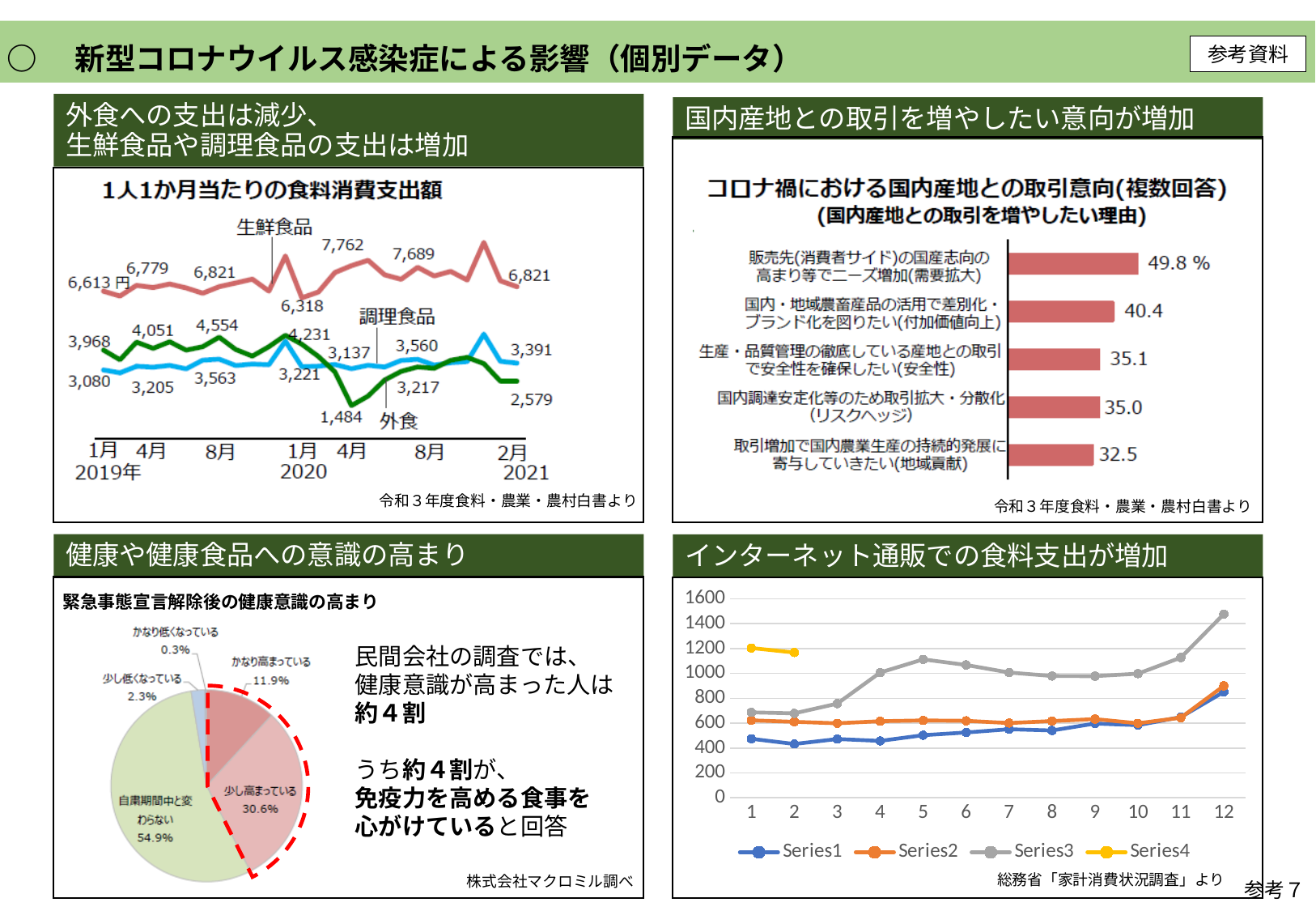
In the top-left chart titled 1人1か月当たりの食料消費支出額, what is the lowest labelled value for 外食? 1,484 In the top-left chart titled 1人1か月当たりの食料消費支出額, what is the highest labelled value for 生鮮食品? 7,762 In the bottom-left pie chart 緊急事態宣言解除後の健康意識の高まり, what share is 自粛期間中と変わらない? 54.9% In the top-left chart titled 1人1か月当たりの食料消費支出額, how many series are plotted? 3 In the top-left chart titled 1人1か月当たりの食料消費支出額, what is the value for 生鮮食品 at 2月 2021? 6,821 In the top-right chart titled コロナ禍における国内産地との取引意向, which reason has the lowest value? 取引増加で国内農業生産の持続的発展に寄与していきたい(地域貢献) In the bottom-left pie chart 緊急事態宣言解除後の健康意識の高まり, what is the combined share of かなり高まっている and 少し高まっている? 42.5% In the top-right chart titled コロナ禍における国内産地との取引意向, what is the value for the top bar (販売先の国産志向の高まり等でニーズ増加)? 49.8% In the bottom-right chart under インターネット通販での食料支出が増加, is the value for Series3 at 12 greater or less than 1400? greater In the top-right chart titled コロナ禍における国内産地との取引意向, what is the difference between the highest and lowest bars? 17.3 In the top-right chart titled コロナ禍における国内産地との取引意向, how many bars are shown? 5 In the top-left chart titled 1人1か月当たりの食料消費支出額, what is the value for 外食 at 2月 2021? 2,579